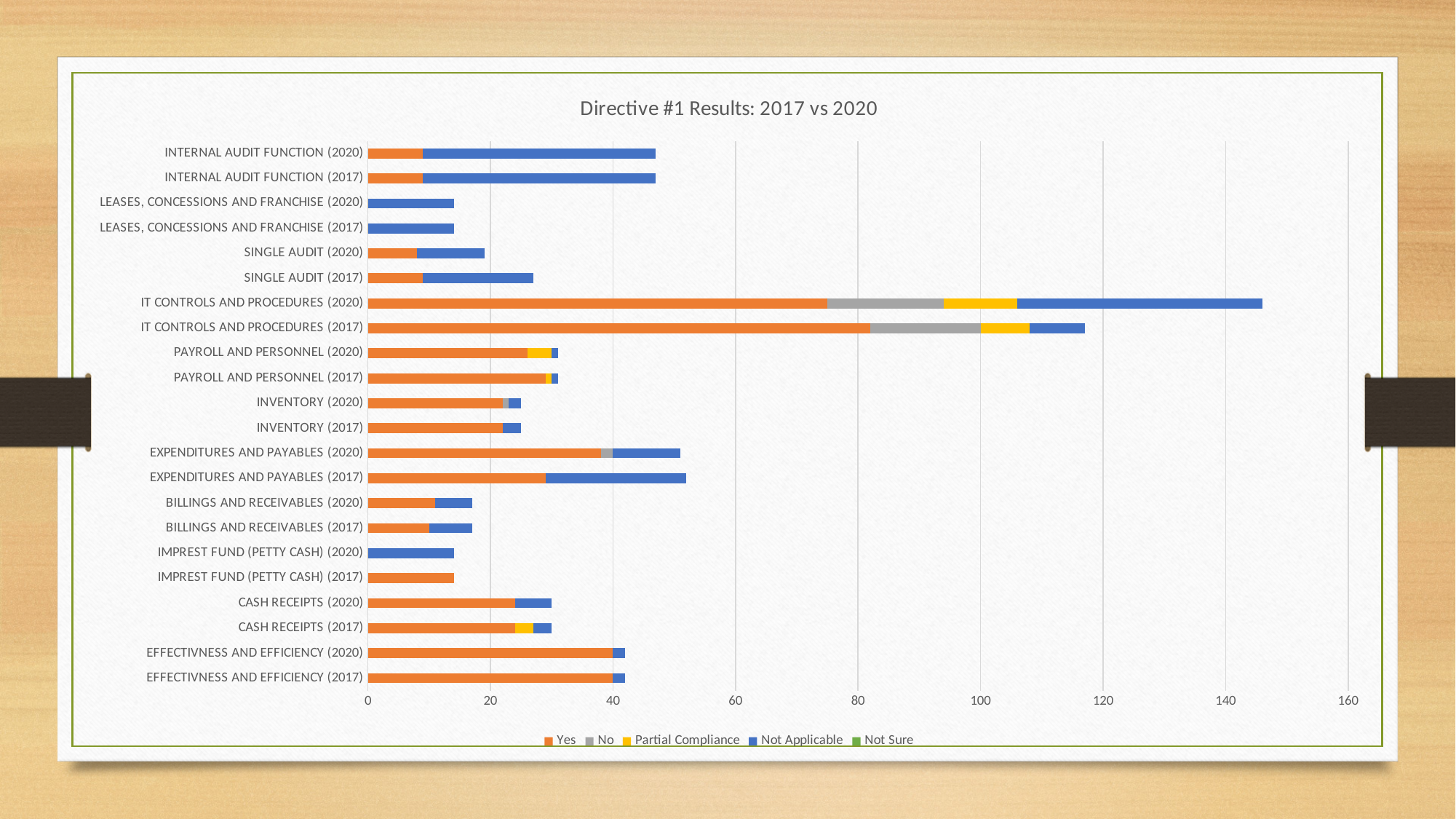
Which series is shown in orange in the legend? Yes Is the total bar length for IT CONTROLS AND PROCEDURES (2020) greater or less than 140? greater Which has the longer total bar, SINGLE AUDIT (2017) or SINGLE AUDIT (2020)? SINGLE AUDIT (2017) Which category has the longest total bar? IT CONTROLS AND PROCEDURES (2020) What is the title of the chart? Directive #1 Results: 2017 vs 2020 Is the total bar length for IT CONTROLS AND PROCEDURES (2017) greater or less than 120? less What kind of chart is shown on the slide? Stacked bar chart How many category bars are plotted on the chart? 22 Which has the longer total bar, IT CONTROLS AND PROCEDURES (2020) or IT CONTROLS AND PROCEDURES (2017)? IT CONTROLS AND PROCEDURES (2020) Is the total bar length for EXPENDITURES AND PAYABLES (2017) greater or less than 40? greater How many series does the legend list? 5